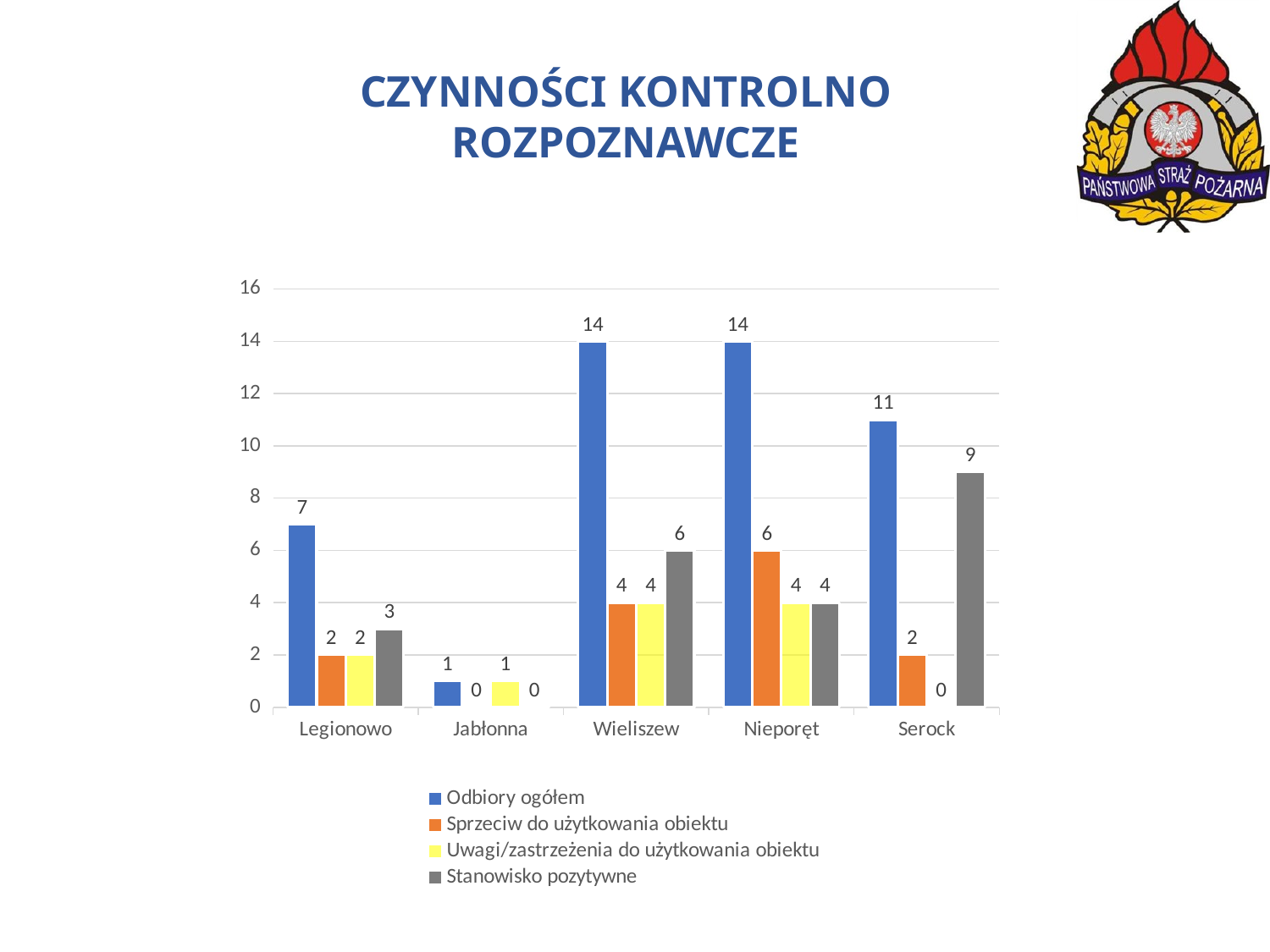
What kind of chart is shown on the slide? Bar chart How many series does the legend list? 4 Which category has the highest value for Stanowisko pozytywne? Serock What is the title of the slide? CZYNNOŚCI KONTROLNO ROZPOZNAWCZE What is the difference between Odbiory ogółem and Stanowisko pozytywne for Wieliszew? 8 What is the value of Sprzeciw do użytkowania obiektu for Nieporęt? 6 Which category has the lowest value for Odbiory ogółem? Jabłonna What is the value of Stanowisko pozytywne for Legionowo? 3 What is the value of Odbiory ogółem for Serock? 11 What is the value of Uwagi/zastrzeżenia do użytkowania obiektu for Jabłonna? 1 Which is larger for Serock: Sprzeciw do użytkowania obiektu or Stanowisko pozytywne? Stanowisko pozytywne How many categories are shown on the x axis? 5